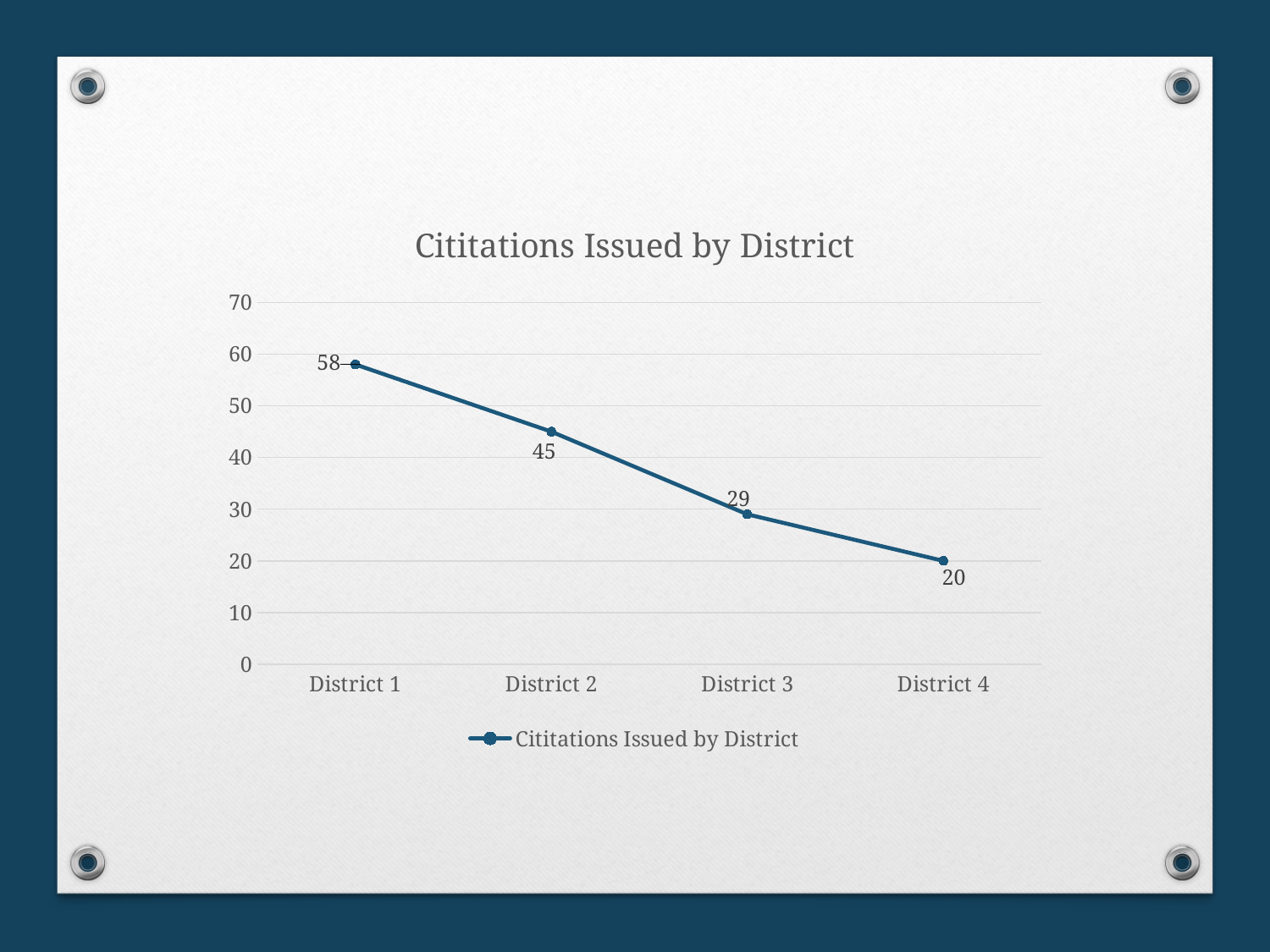
How many districts are shown on the x axis? 4 What is the value for District 1? 58 What is the value for District 4? 20 Is the value for District 3 greater or less than 30? less Which district has the highest number of citations issued? District 1 What is the value for District 3? 29 Which is larger, the value for District 2 or District 3? District 2 Which district has the lowest number of citations issued? District 4 Do the values rise or fall from District 1 to District 4? fall What kind of chart is shown on the slide? line chart What is the value for District 2? 45 What is the difference between the values for District 1 and District 4? 38